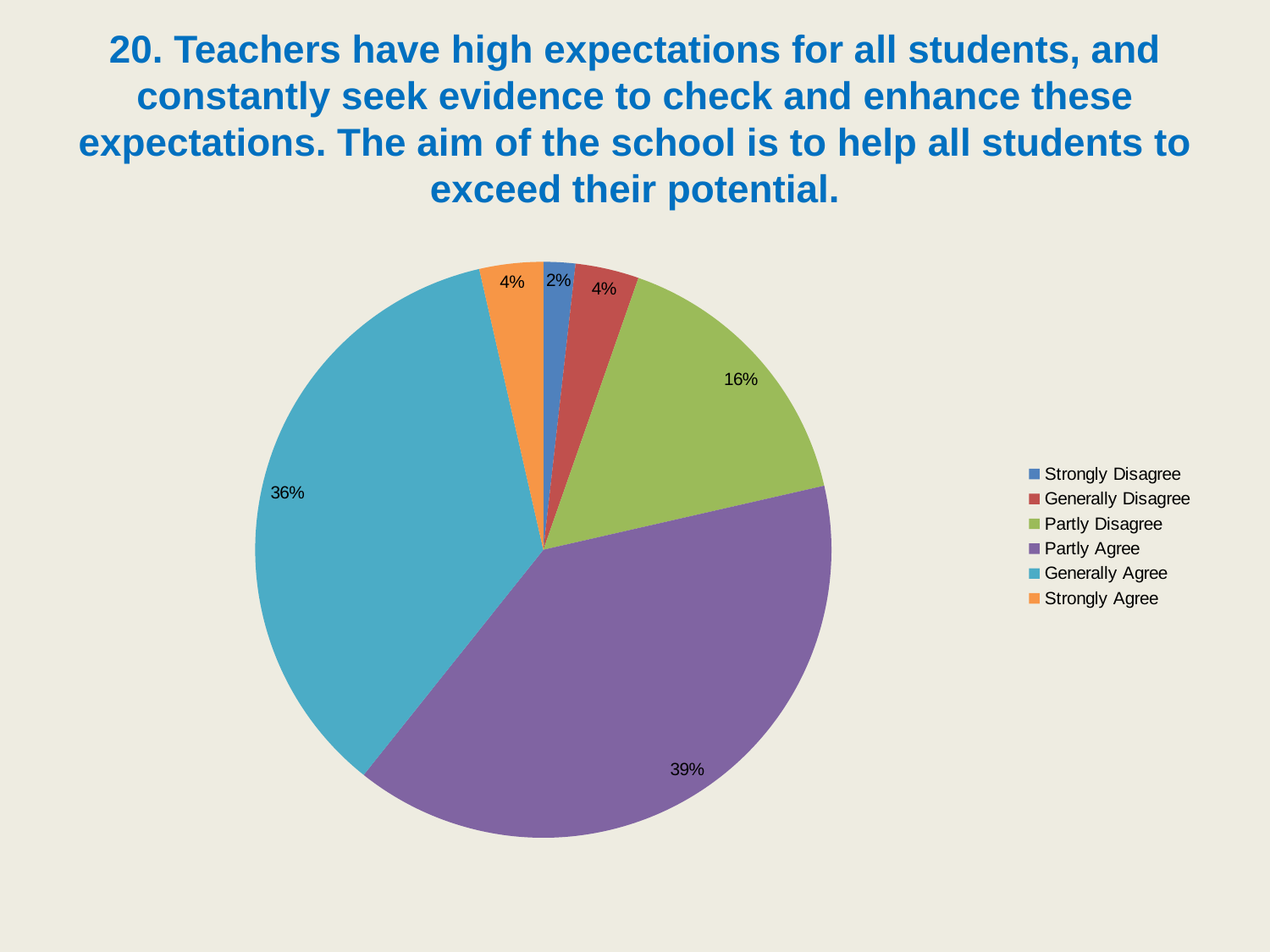
What percentage of responses are Generally Agree? 36% Which response category has the smallest share of the pie? Strongly Disagree What colour is the Generally Agree slice? teal (light blue) Which response category has the largest share of the pie? Partly Agree What percentage of responses are Partly Agree? 39% Which is larger, the share for Partly Disagree or the share for Generally Disagree? Partly Disagree What kind of chart is shown on the slide? pie chart What is the difference in percentage points between Partly Agree and Generally Agree? 3 How many response categories does the legend list? 6 What percentage of responses are Strongly Disagree? 2% What percentage of responses are Partly Disagree? 16% What percentage of responses are Strongly Agree? 4%